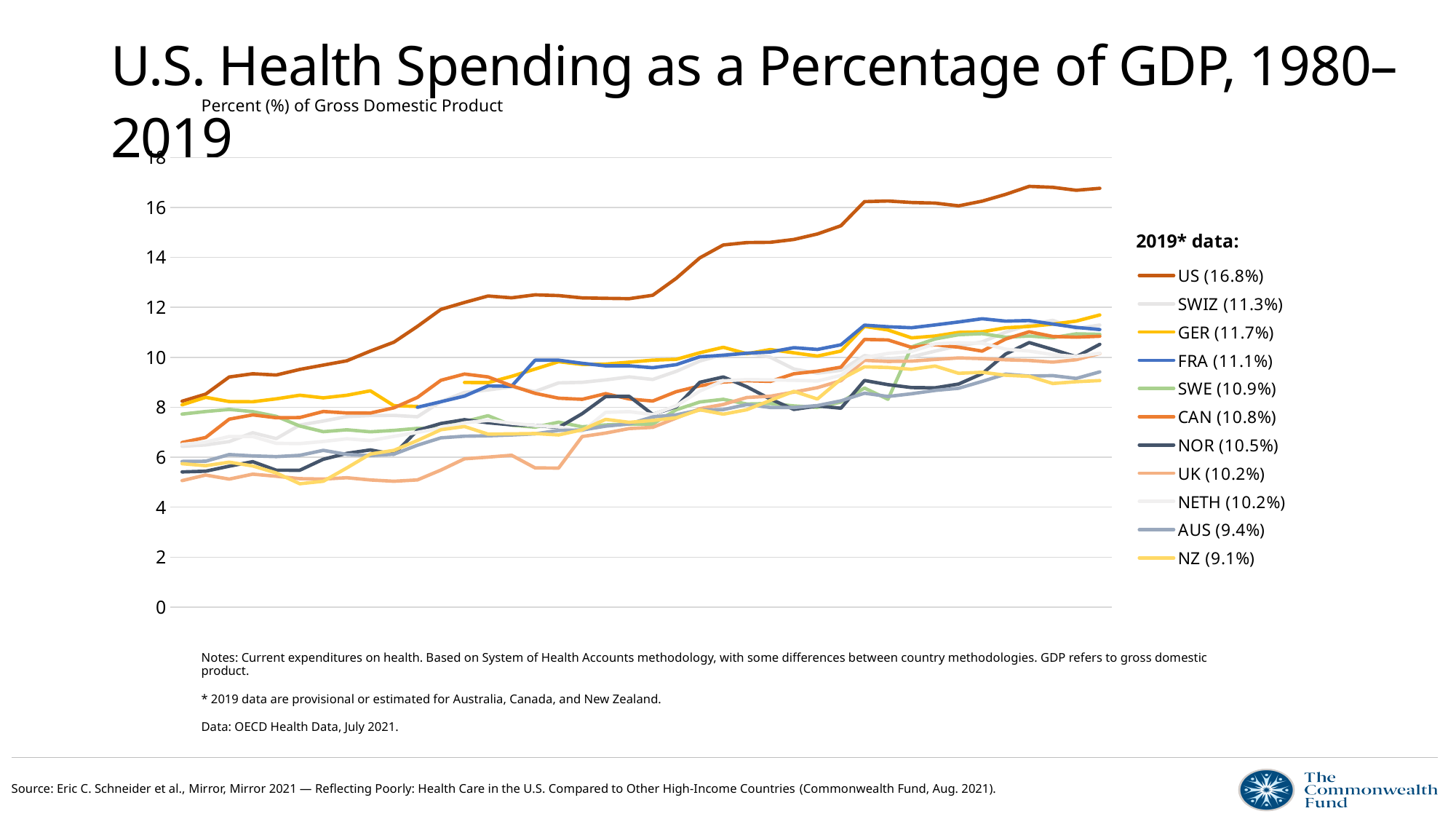
Is the value of the US line at the start of the series (1980) greater or less than 10? less Which has the larger 2019 value, SWIZ or FRA? SWIZ How many countries (series) does the legend list? 11 Does the US line generally rise or fall from left to right across the chart? Rise What 2019 value does the legend give for GER? 11.7% By how many percentage points does the 2019 US value exceed the 2019 GER value? 5.1 Which country has the lowest 2019 value in the legend? NZ According to the legend, what was U.S. health spending as a percentage of GDP in 2019? 16.8% What 2019 value does the legend give for AUS? 9.4% What kind of chart is shown on the slide? Line chart Which country has the highest 2019 value in the legend? US What is the label shown above the y axis of the chart? Percent (%) of Gross Domestic Product